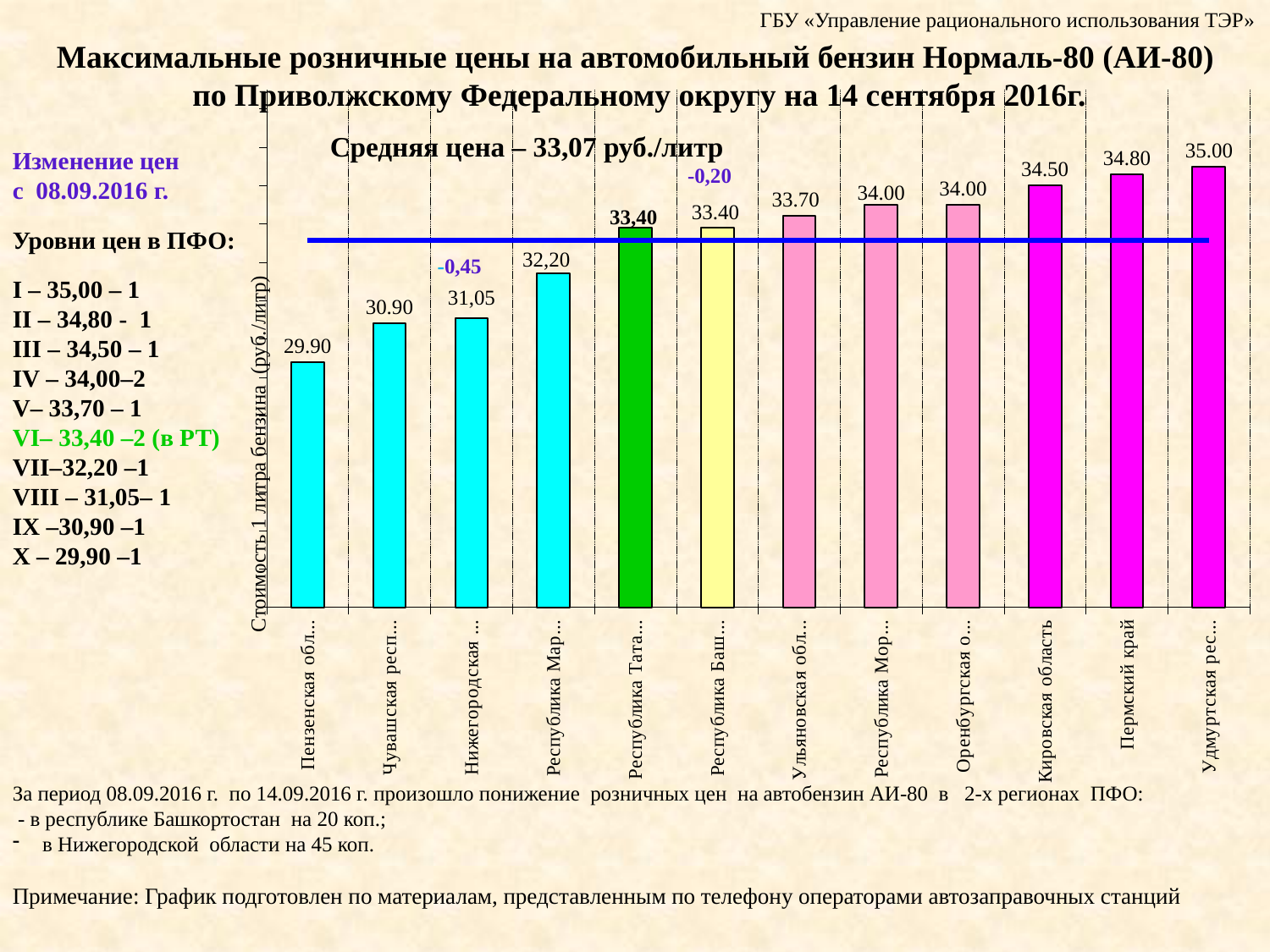
What is the difference between the values for Пермский край and Кировская область? 0.30 What is the value shown for Кировская область? 34.50 What kind of chart is shown on the slide? bar chart What is the value shown for the yellow bar, Республика Баш...? 33.40 Which has a larger value, Кировская область or Пермский край? Пермский край Do the values rise or fall from left to right along the x axis? rise What is the lowest value shown on the chart? 29.90 What average price (Средняя цена) is stated above the chart? 33,07 руб./литр What is the value shown for the first bar, Пензенская обл...? 29.90 What is the highest value shown on the chart? 35.00 What is the value shown for Пермский край? 34.80 How many bars are shown on the chart? 12